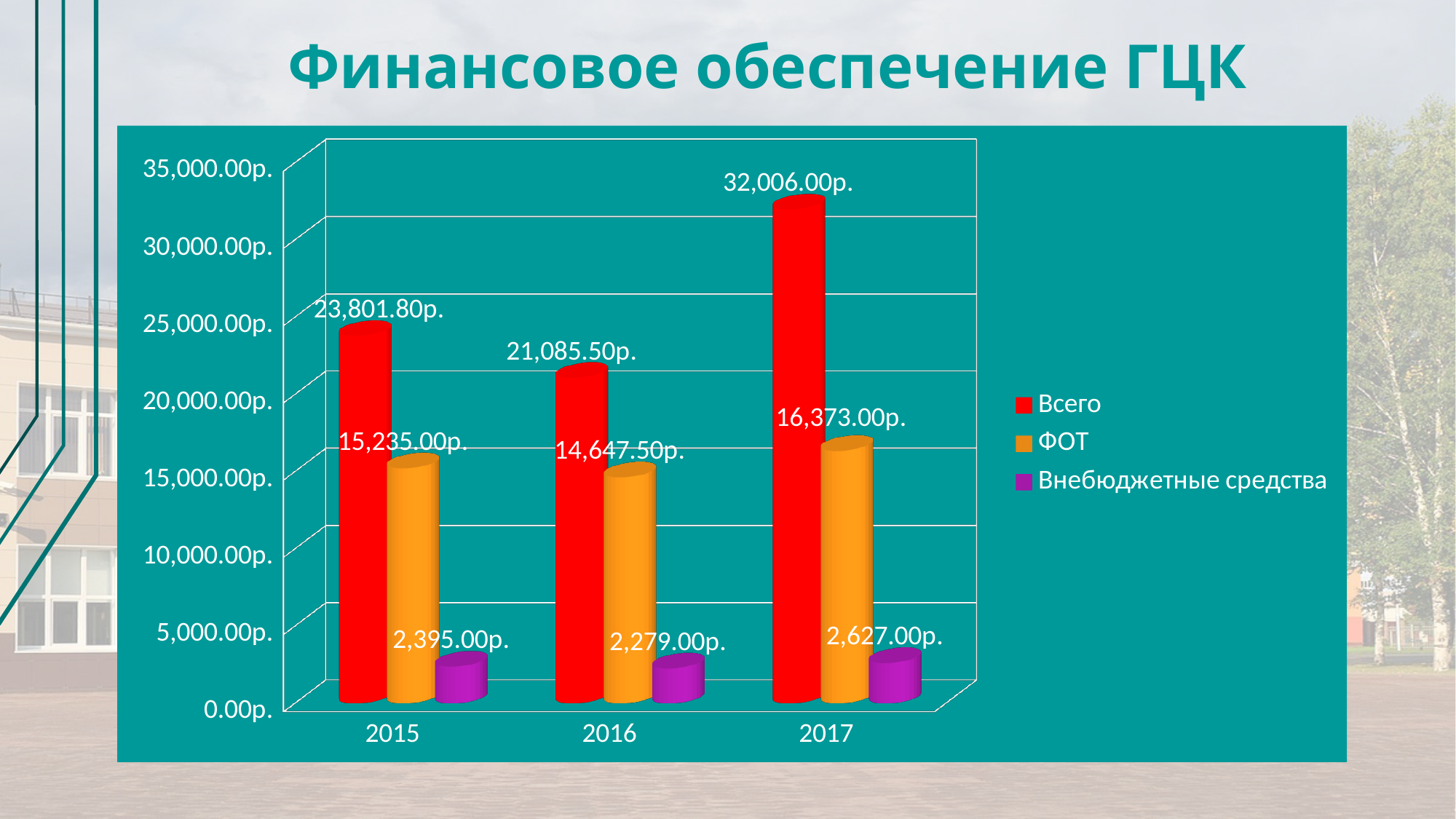
What colour represents the series Внебюджетные средства? Purple What is the value of ФОТ for 2016? 14,647.50р. What is the value of Всего for 2017? 32,006.00р. In which year is ФОТ the lowest? 2016 In which year is Всего the highest? 2017 What is the value of Всего for 2015? 23,801.80р. What is the difference between Всего in 2017 and Всего in 2015? 8,204.20р. Which is larger: Всего in 2015 or Всего in 2016? Всего in 2015 What is the value of Внебюджетные средства for 2015? 2,395.00р. What is the difference between ФОТ in 2017 and ФОТ in 2016? 1,725.50р. How many series does the legend list? 3 What kind of chart is shown on the slide? Bar chart